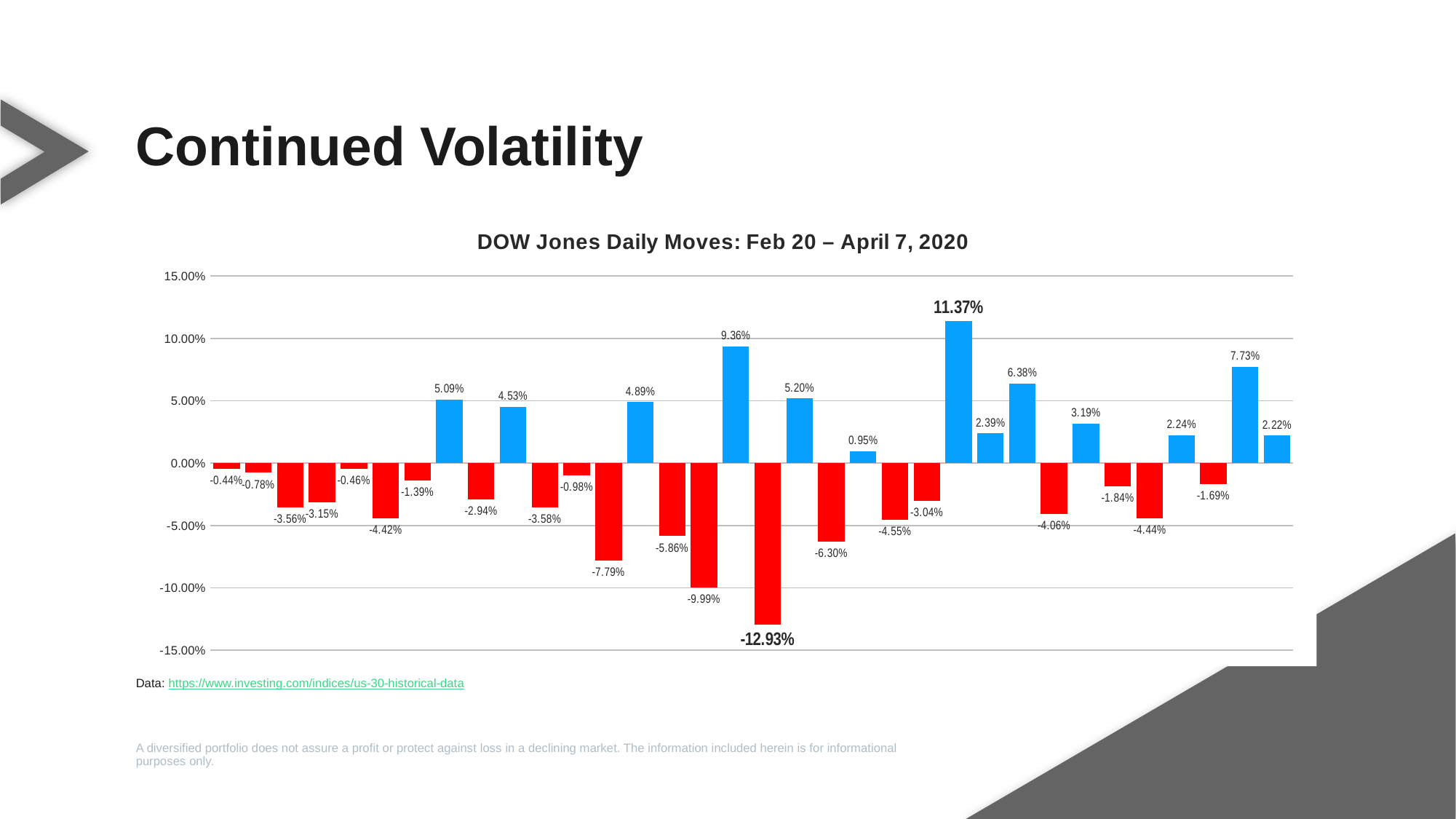
What is the largest single-day gain shown in the chart? 11.37% How many of the daily moves in the chart are negative (red bars)? 21 What type of chart is shown on the slide? bar chart What colour are the bars representing negative daily moves? red How many bars in the chart exceed 10.00%? 1 How many of the daily moves in the chart are positive (blue bars)? 13 What is the difference in percentage points between the largest gain (11.37%) and the largest loss (-12.93%)? 24.30 percentage points What is the second-largest positive daily move shown in the chart? 9.36% What is the second-largest negative daily move shown in the chart? -9.99% What is the largest single-day loss shown in the chart? -12.93% What is the title of the chart? DOW Jones Daily Moves: Feb 20 – April 7, 2020